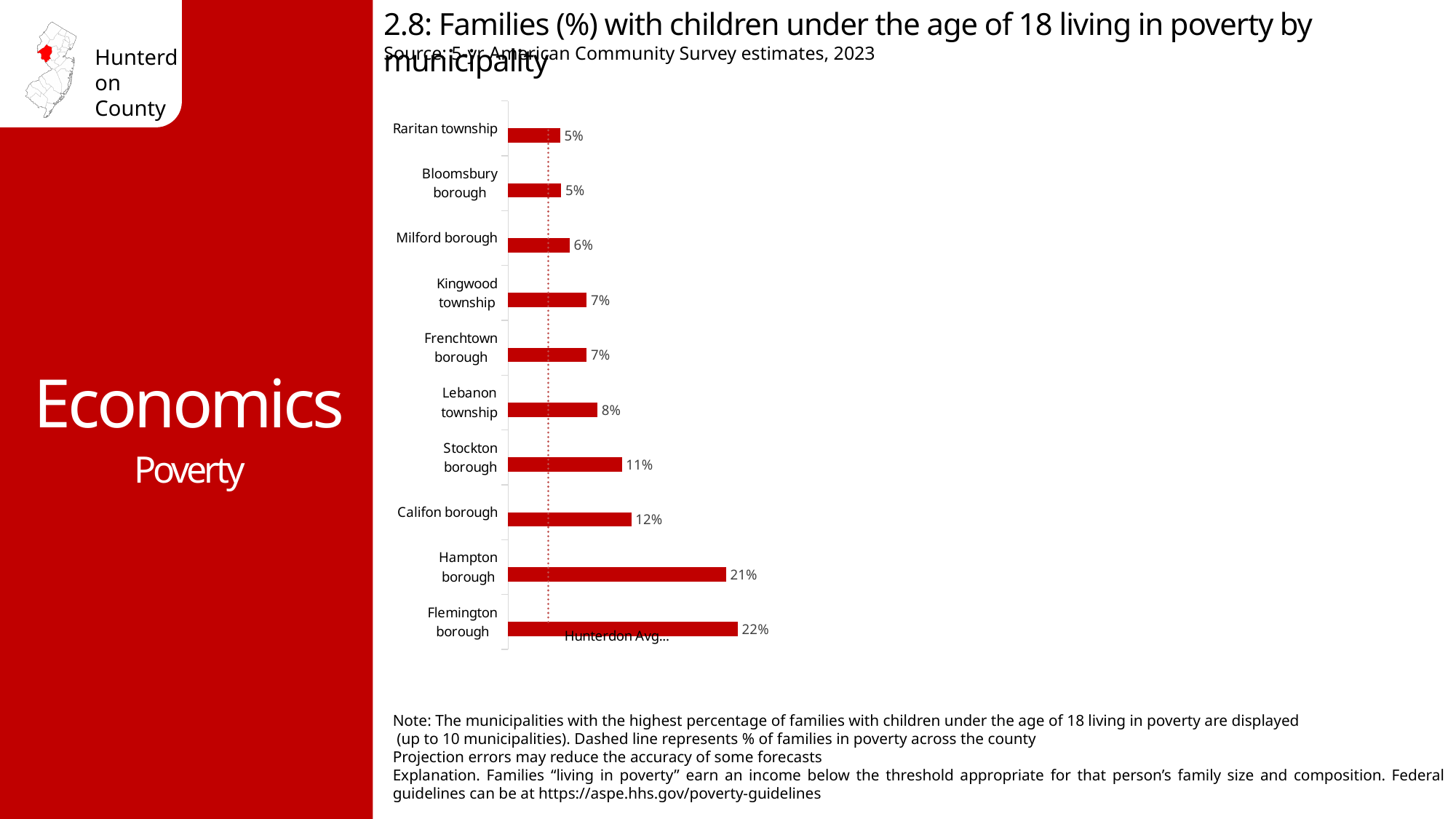
What is the value shown for Lebanon township? 8% What does the dashed vertical line in the chart represent? Hunterdon Avg (% of families in poverty across the county) How many municipalities are shown in the chart? 10 What is the difference in percentage points between Hampton borough and Stockton borough? 10 What percentage of families with children under 18 are living in poverty in Flemington borough? 22% What is the value shown for Hampton borough? 21% What is the value shown for Stockton borough? 11% What is the difference in percentage points between Flemington borough and Califon borough? 10 Which has a higher value, Lebanon township or Raritan township? Lebanon township What type of chart is used on this slide? Bar chart Which municipality has the highest percentage of families with children under 18 living in poverty? Flemington borough Which has a higher value, Califon borough or Milford borough? Califon borough